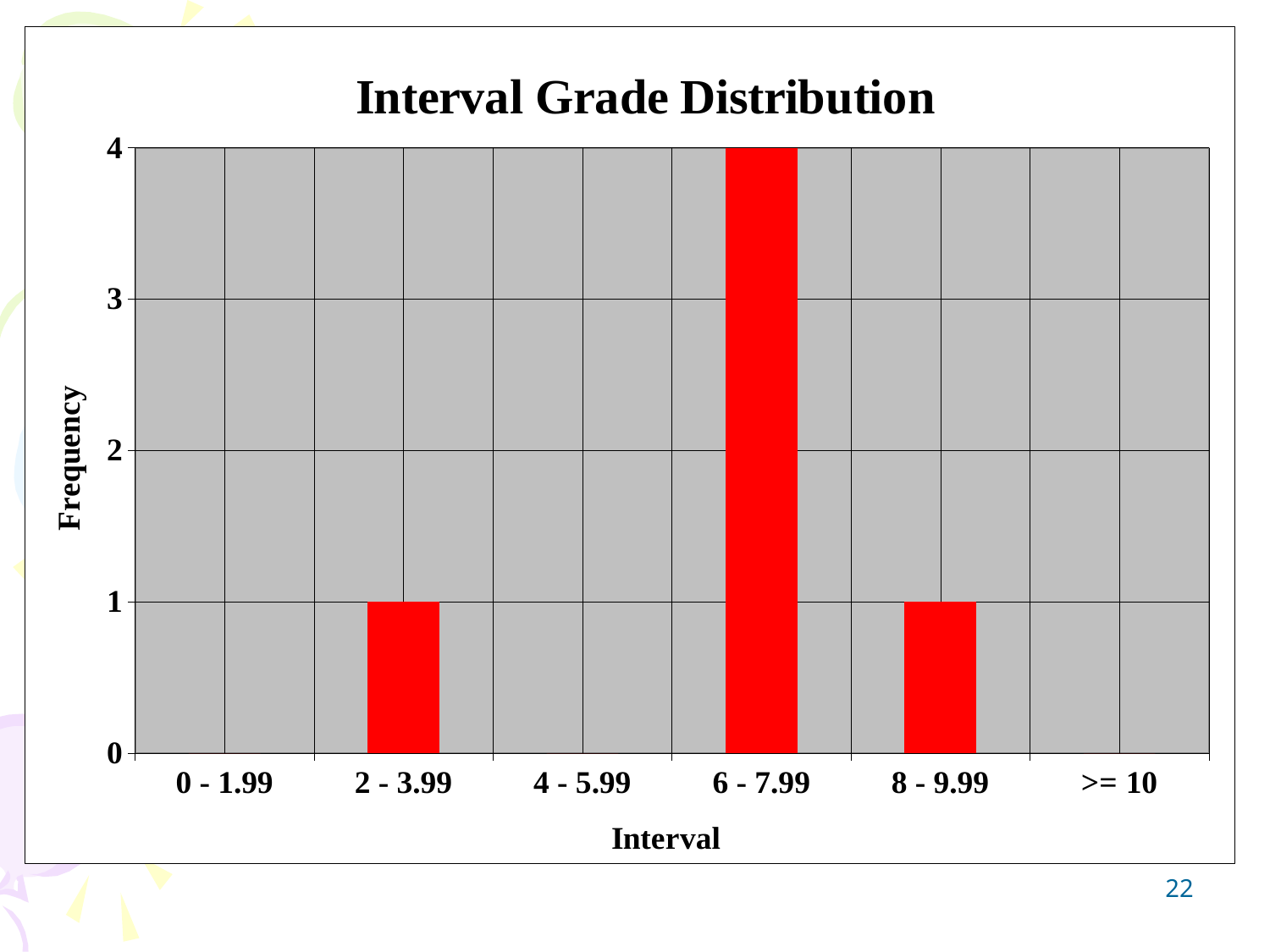
What is the label of the y axis? Frequency Is the frequency for the 6 - 7.99 interval greater or less than 2? greater How many intervals are shown on the x axis? 6 What is the frequency for the interval 8 - 9.99? 1 What is the title of the chart? Interval Grade Distribution What is the frequency for the interval 6 - 7.99? 4 What is the difference in frequency between the 6 - 7.99 interval and the 2 - 3.99 interval? 3 What kind of chart is shown on the slide? bar chart Which interval has the highest frequency? 6 - 7.99 What is the frequency for the interval 2 - 3.99? 1 Which has a higher frequency, the 6 - 7.99 interval or the 8 - 9.99 interval? 6 - 7.99 What is the frequency for the interval 0 - 1.99? 0